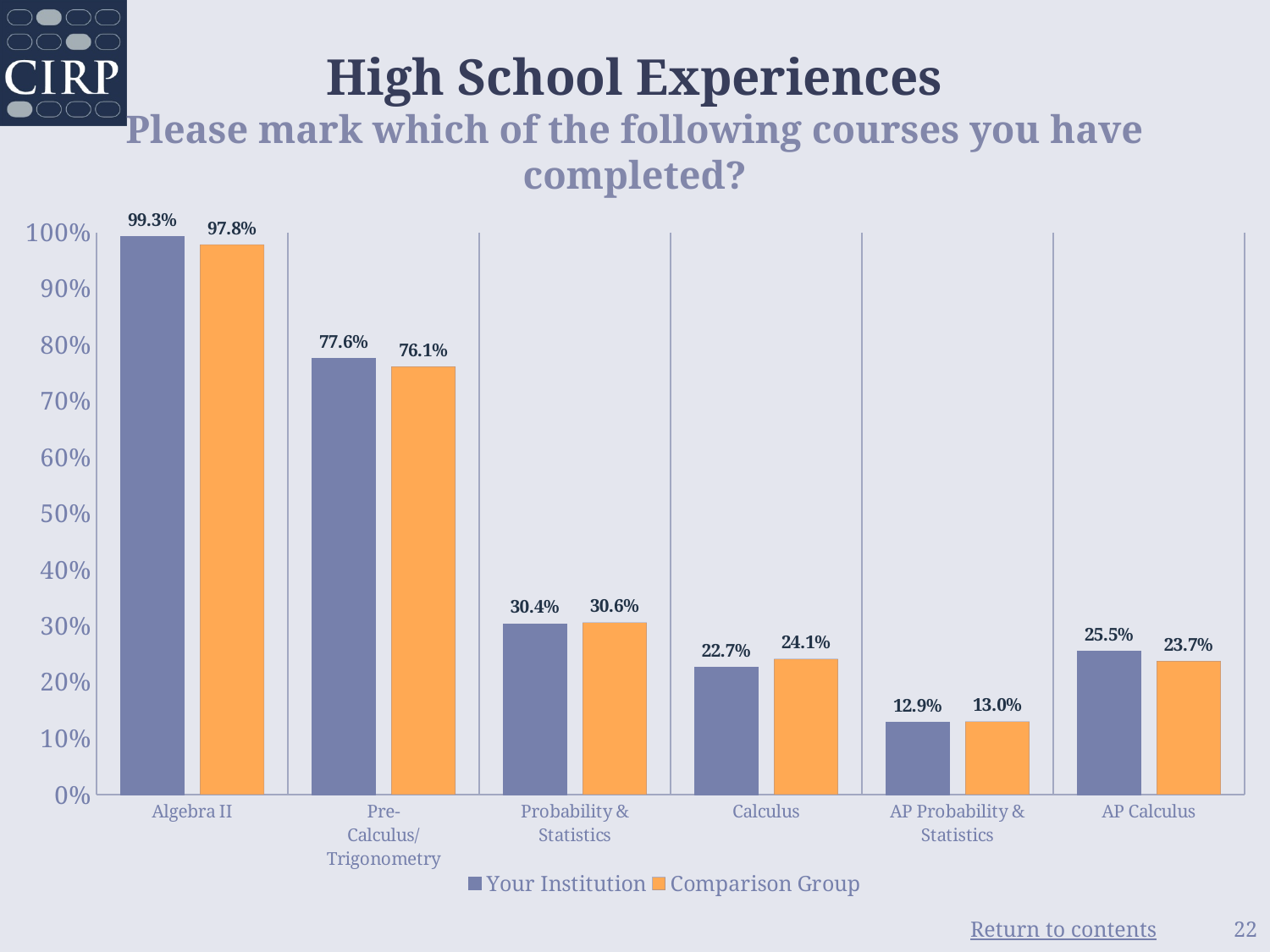
Which course has the highest Comparison Group value? Algebra II What percentage of Your Institution students completed Algebra II? 99.3% How many series does the legend list? 2 Is the Your Institution value for Probability & Statistics greater or less than 40%? less For Calculus, which is larger: Your Institution or Comparison Group? Comparison Group Which course has the lowest Your Institution value? AP Probability & Statistics What is the Comparison Group value for Calculus? 24.1% What kind of chart is shown on the slide? bar chart Which colour represents the Comparison Group series? orange How many courses are shown on the x axis? 6 What is the difference between the Your Institution and Comparison Group values for Pre-Calculus/Trigonometry? 1.5% What is the Your Institution value for AP Calculus? 25.5%